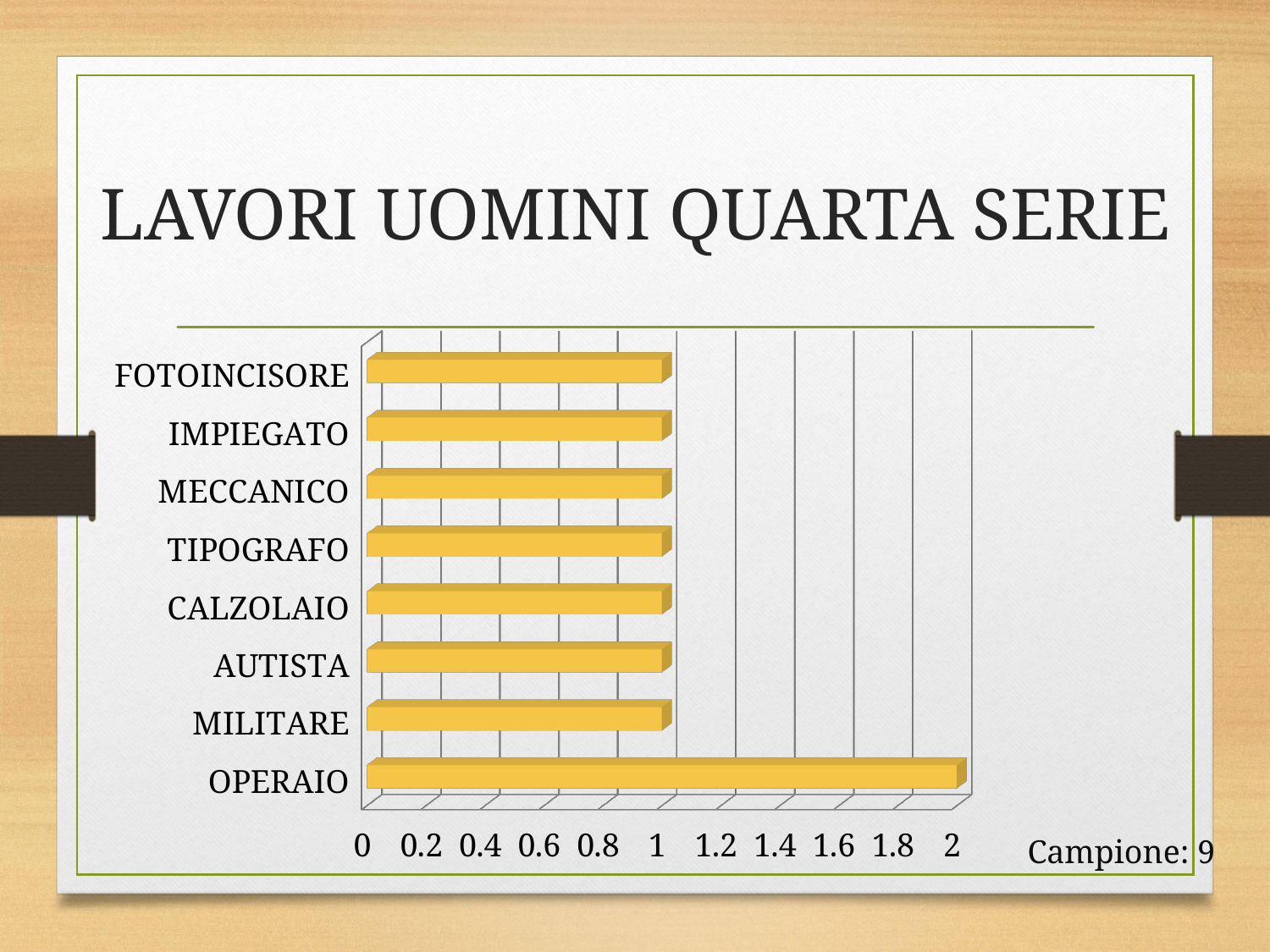
What is the title of the slide? LAVORI UOMINI QUARTA SERIE What is the difference between the values for OPERAIO and AUTISTA? 1 What sample size (Campione) is stated on the slide? 9 Is the value for OPERAIO greater or less than 1.8? greater How many categories (jobs) are shown in the chart? 8 What is the value for MILITARE? 1 Which job has the highest value in the chart? OPERAIO What kind of chart is shown on the slide? bar chart What is the value for FOTOINCISORE? 1 Is the value for TIPOGRAFO greater or less than 1.2? less What is the value for OPERAIO? 2 Which is larger, the value for OPERAIO or the value for CALZOLAIO? OPERAIO